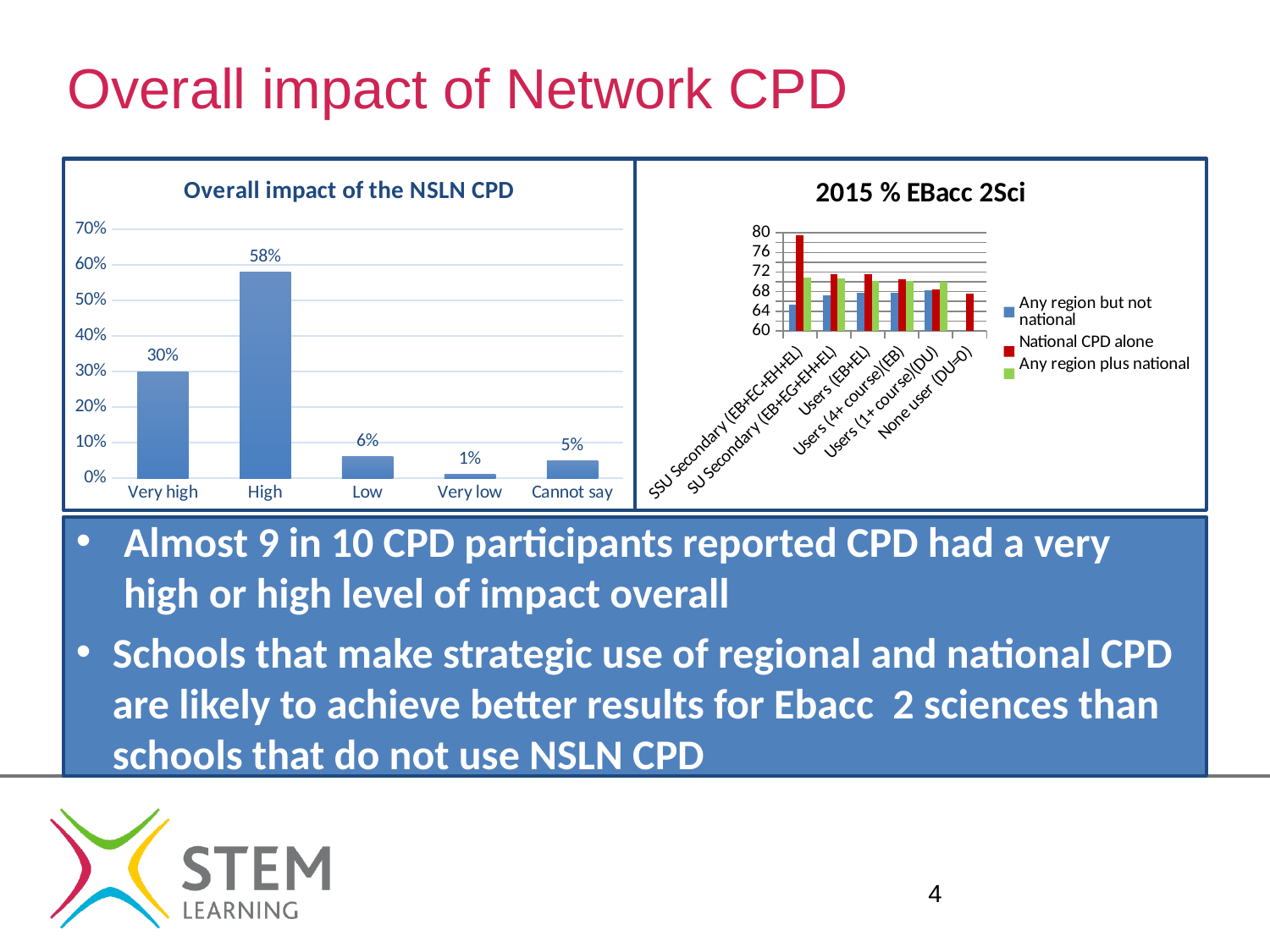
In the 'Overall impact of the NSLN CPD' chart, which is larger: 'Low' or 'Cannot say'? Low In the '2015 % EBacc 2Sci' chart, is the 'National CPD alone' value for the first category (SSU Secondary) greater or less than 76? greater In the 'Overall impact of the NSLN CPD' chart, what percentage is shown for 'Very high'? 30% In the 'Overall impact of the NSLN CPD' chart, how many categories are shown on the x axis? 5 In the 'Overall impact of the NSLN CPD' chart, which category has the lowest value? Very low In the 'Overall impact of the NSLN CPD' chart, what is the combined value of 'Very high' and 'High'? 88% In the 'Overall impact of the NSLN CPD' chart, what percentage is shown for 'High'? 58% What kind of chart is the '2015 % EBacc 2Sci' chart? Bar chart In the 'Overall impact of the NSLN CPD' chart, what is the difference between the 'High' and 'Very high' values? 28% In the 'Overall impact of the NSLN CPD' chart, which category has the highest value? High In the '2015 % EBacc 2Sci' chart, which series is shown in red in the legend? National CPD alone How many series does the legend of the '2015 % EBacc 2Sci' chart list? 3